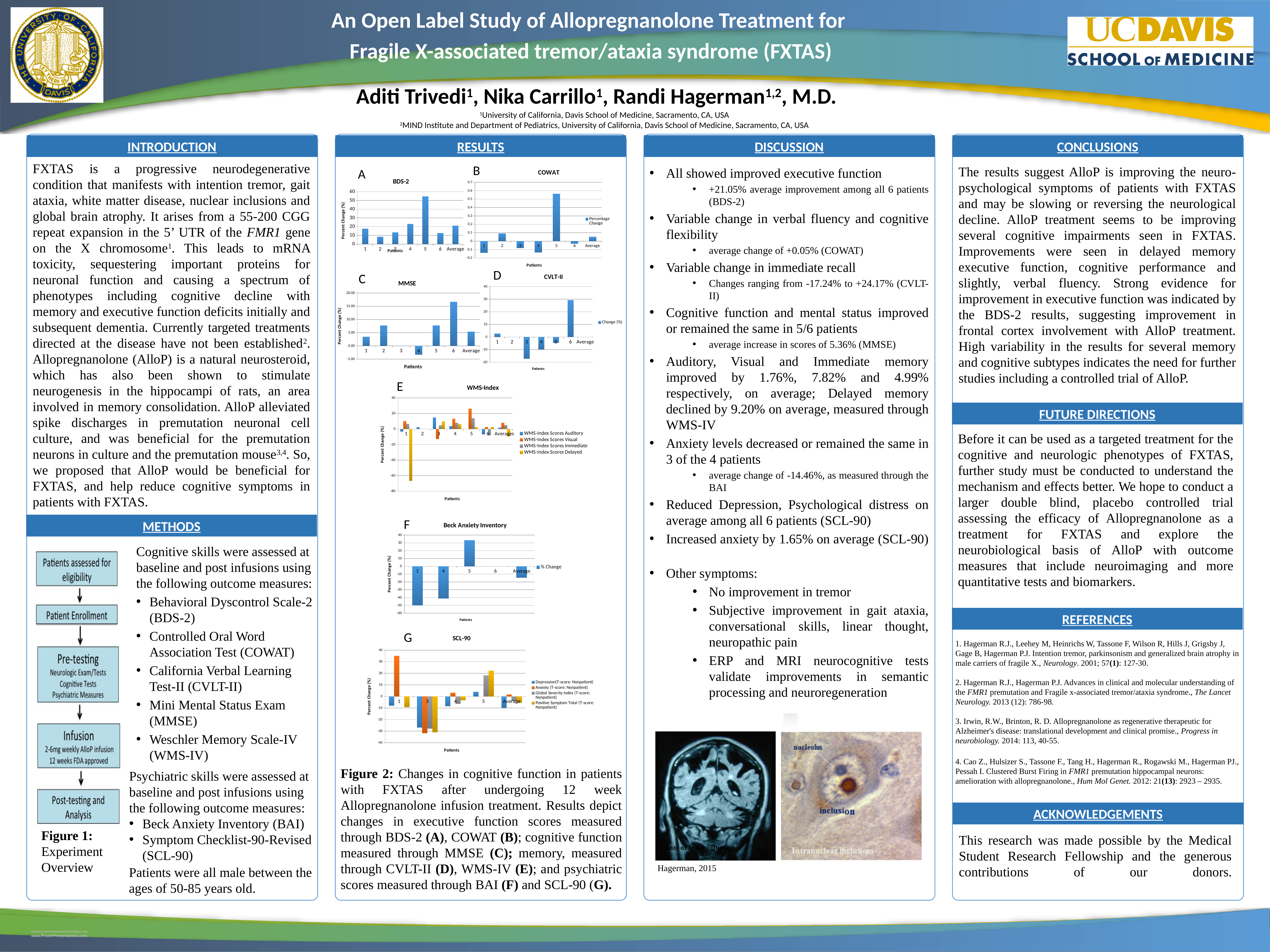
In chart A (BDS-2), which patient shows the highest percent change? 5 In chart F (Beck Anxiety Inventory), is the value for patient 5 greater or less than 20? greater What is the title of chart G? SCL-90 In chart D (CVLT-II), is the value for patient 6 greater or less than 20? greater How many series does the legend of chart E (WMS-Index) list? 4 What kind of chart is chart A (BDS-2)? bar chart In chart C (MMSE), which patient shows the highest percent change? 6 In chart A (BDS-2), is the value for patient 5 greater or less than 40? greater In chart D (CVLT-II), which patient shows the lowest change? 3 In chart F (Beck Anxiety Inventory), which patient shows the lowest percent change? 1 In chart B (COWAT), which patient shows the highest percentage change? 5